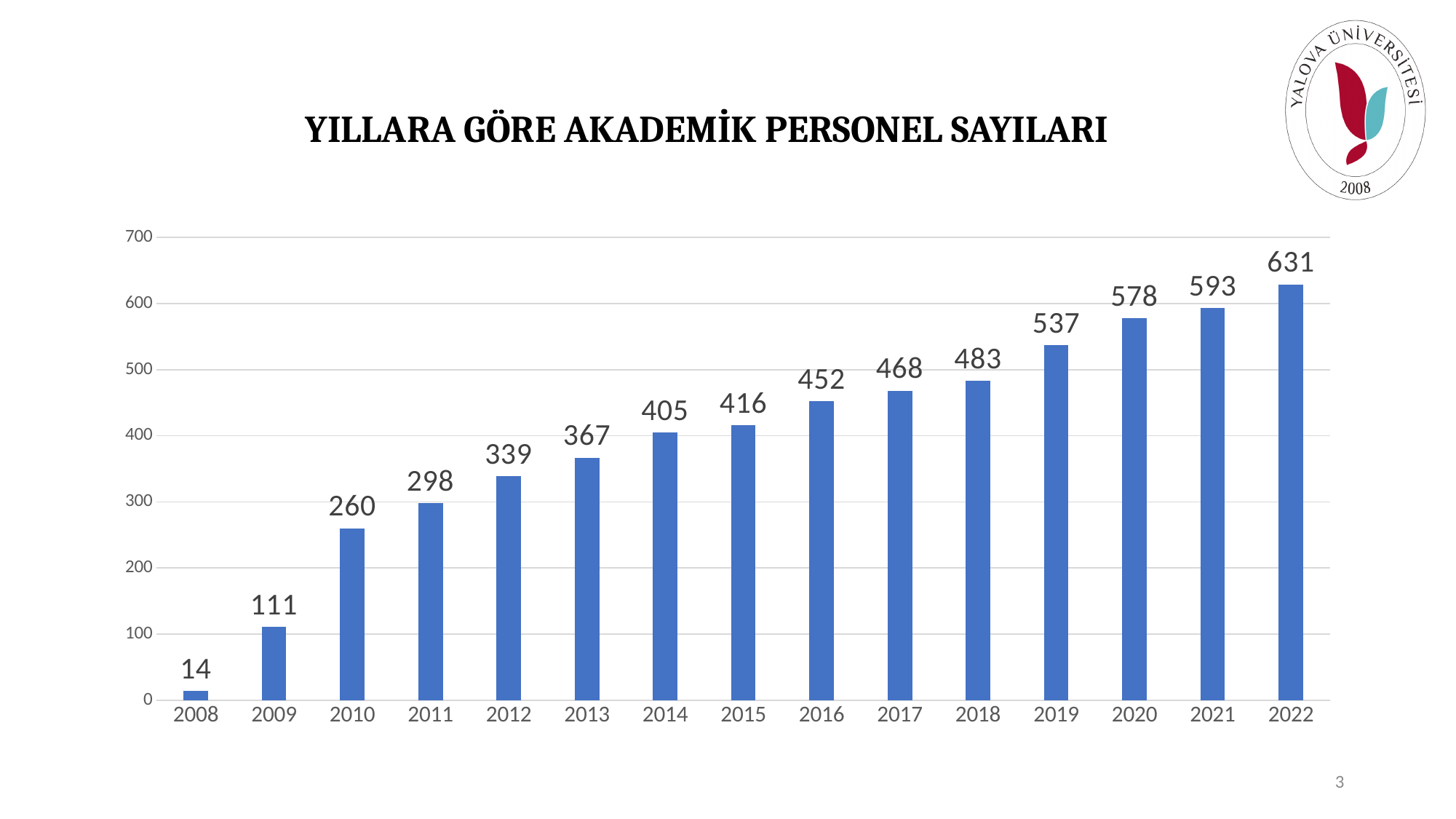
What is the difference between the values for 2022 and 2021? 38 Which year has the highest value? 2022 What kind of chart is shown on the slide? bar chart What is the value for 2008? 14 Which year has the lowest value? 2008 Which is larger, the value for 2013 or the value for 2016? 2016 Do the values rise or fall from 2008 to 2022? rise What is the value for 2020? 578 What is the value for 2015? 416 Is the value for 2019 greater or less than 500? greater What is the difference between the values for 2010 and 2009? 149 How many years are shown on the x axis? 15